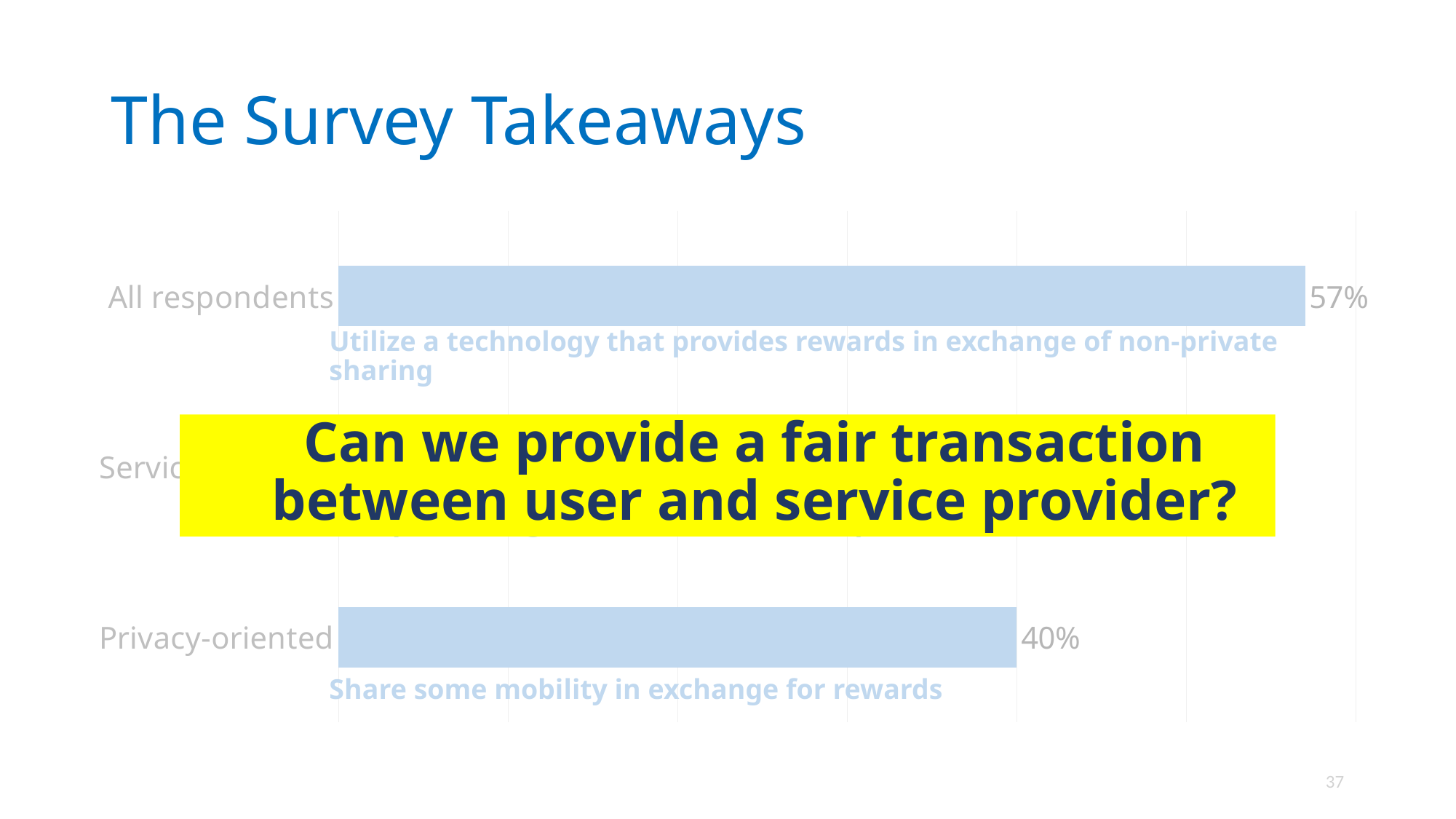
What is the difference between the values for All respondents and Privacy-oriented? 17% What text is written beneath the Privacy-oriented bar? Share some mobility in exchange for rewards What kind of chart is shown on the slide? Bar chart What is the value for All respondents? 57% Which is larger, the value for All respondents or the value for Privacy-oriented? All respondents What is the title of the slide containing the chart? The Survey Takeaways What is the value for Privacy-oriented? 40%